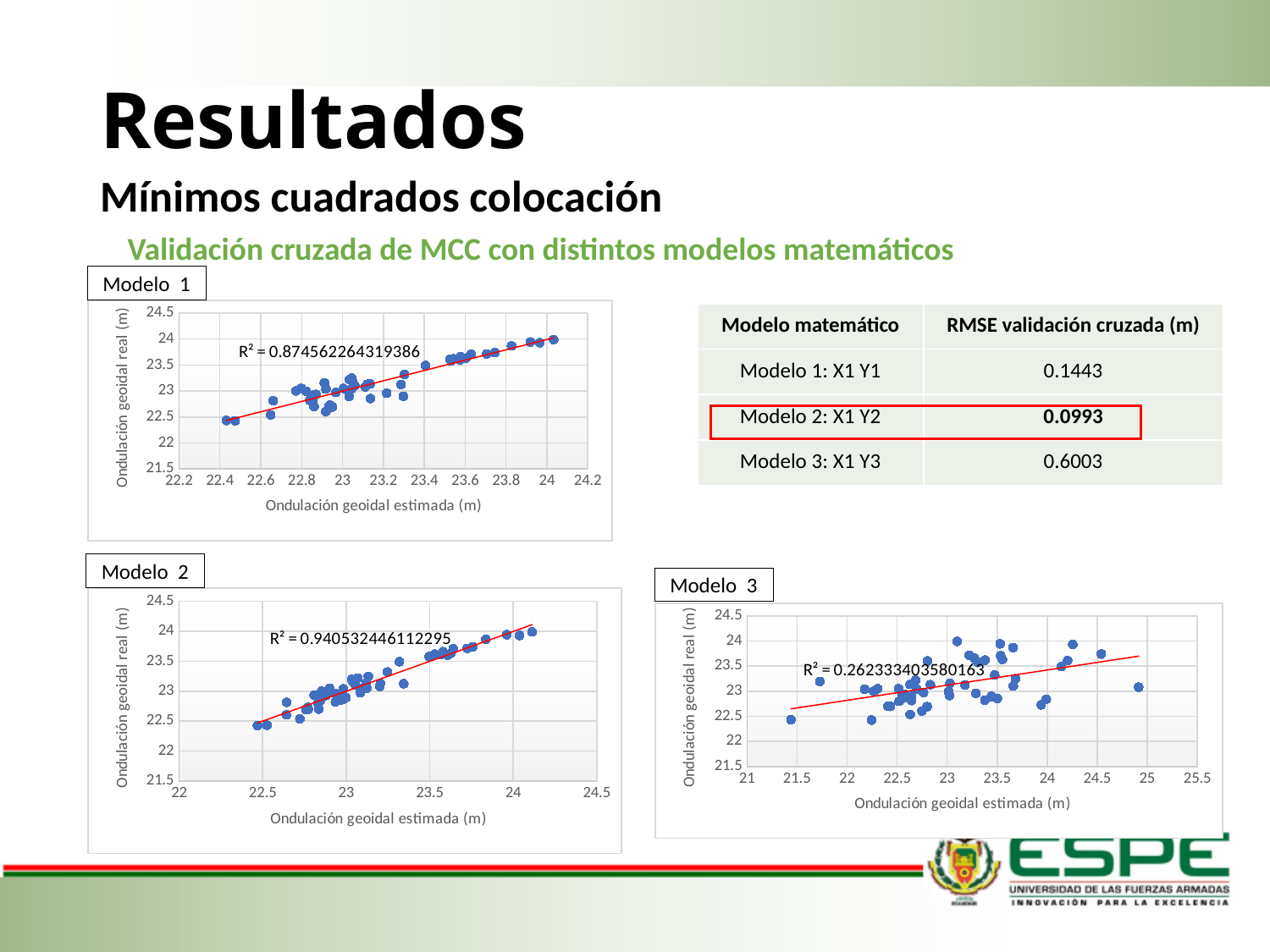
What kind of chart is the Modelo 1 chart? scatter chart Among the three scatter charts, which model has the lowest R² value? Modelo 3 In the Modelo 1 chart, what R² value is printed? R² = 0.874562264319386 What is the y-axis title of the Modelo 3 chart? Ondulación geoidal real (m) How many scatter charts are shown on the slide? 3 In the Modelo 2 chart, what R² value is printed? R² = 0.940532446112295 What is the difference between the R² values of the Modelo 2 chart and the Modelo 1 chart? 0.065970181792909 In the Modelo 3 chart, what R² value is printed? R² = 0.262333403580163 In the Modelo 1 chart, does the red trend line rise or fall as the estimated geoidal undulation increases? rises Which chart shows a higher R² value, Modelo 2 or Modelo 3? Modelo 2 What is the x-axis title of the Modelo 2 chart? Ondulación geoidal estimada (m) Among the three scatter charts, which model has the highest R² value? Modelo 2